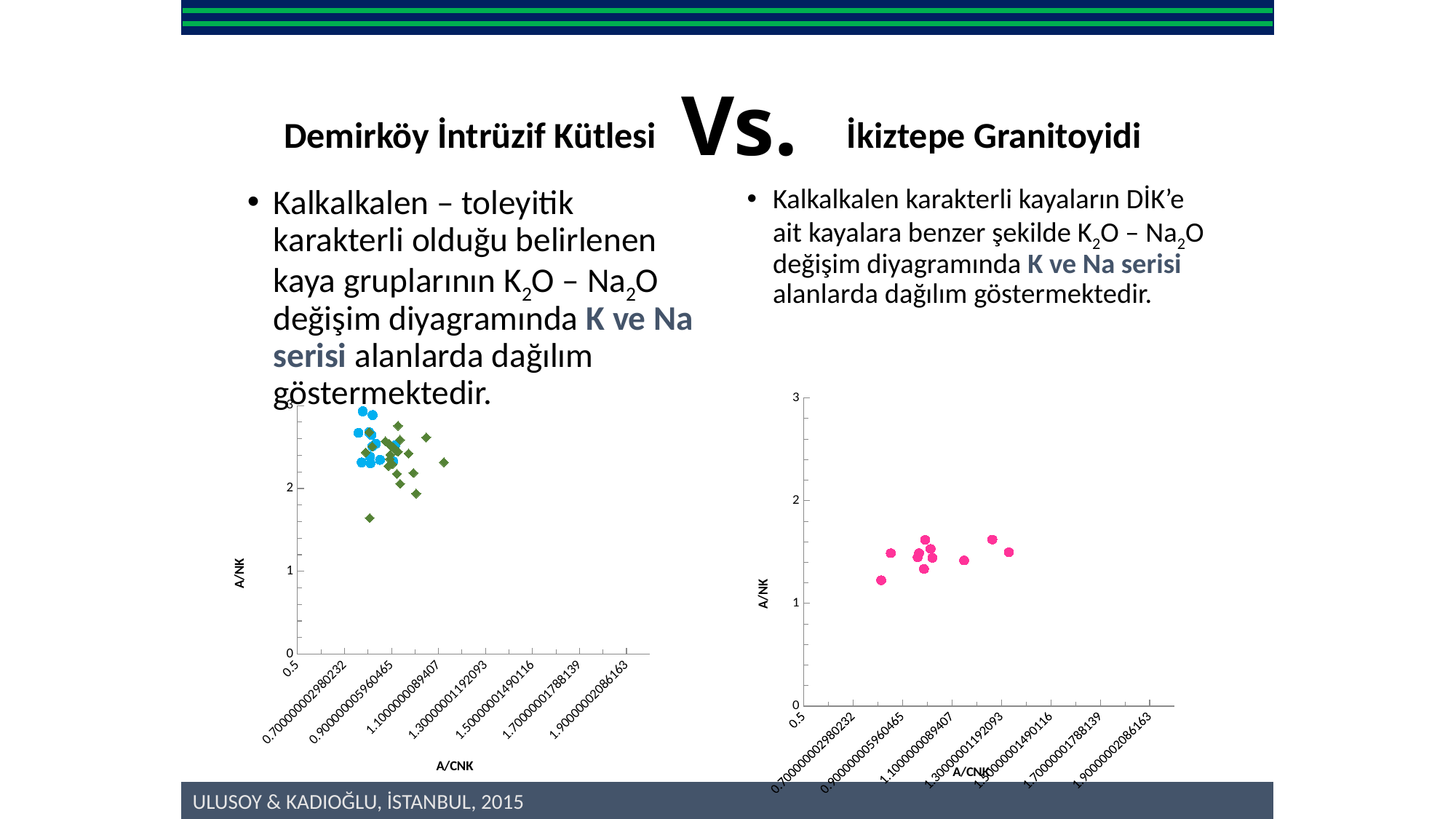
In the left chart, are the blue circle points mostly above or below an A/NK value of 2? above In the left chart, is the lowest green diamond point's A/NK value greater or less than 2? less In the right chart, is the lowest A/NK value plotted greater or less than 1? greater In the right chart, what is the label of the horizontal axis? A/CNK What kind of chart is shown on the right side of the slide, under the İkiztepe Granitoyidi heading? Scatter chart What kind of chart is shown on the left side of the slide, under the Demirköy İntrüzif Kütlesi heading? Scatter chart In the left chart, what is the label of the vertical axis? A/NK Which chart has points with higher A/NK values overall, the left chart or the right chart? The left chart